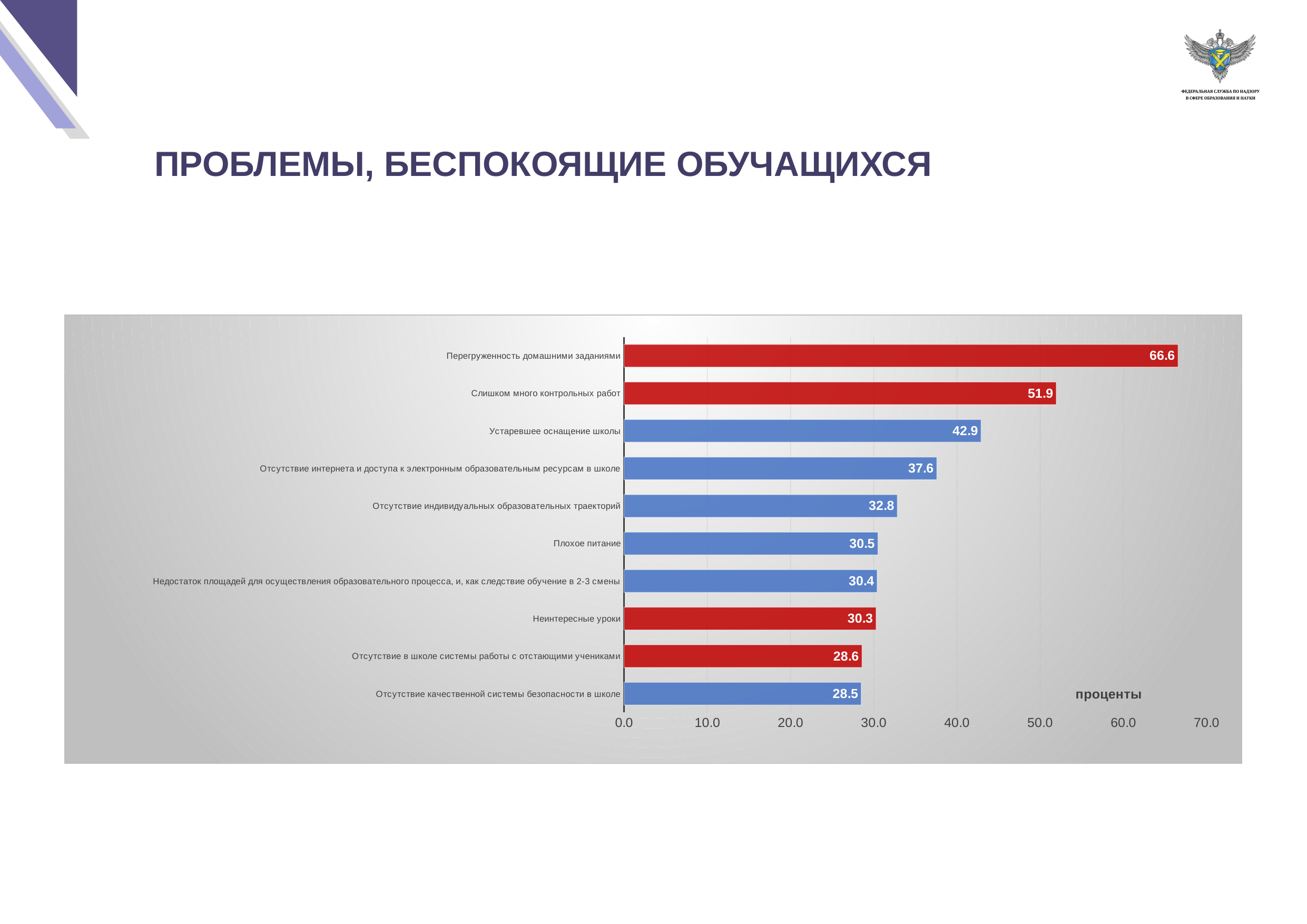
What kind of chart is shown on the slide? Bar chart What is the value for «Отсутствие в школе системы работы с отстающими учениками»? 28.6 What is the value for «Устаревшее оснащение школы»? 42.9 How many categories are shown in the chart? 10 What is the value for «Плохое питание»? 30.5 What colour is the bar for «Неинтересные уроки»? Red Which category has the highest value? Перегруженность домашними заданиями What is the value for «Перегруженность домашними заданиями»? 66.6 What is the difference between the values for «Перегруженность домашними заданиями» and «Слишком много контрольных работ»? 14.7 Which is larger: the value for «Устаревшее оснащение школы» or the value for «Отсутствие интернета и доступа к электронным образовательным ресурсам в школе»? Устаревшее оснащение школы What is the label shown on the horizontal axis of the chart? проценты Which category has the lowest value? Отсутствие качественной системы безопасности в школе